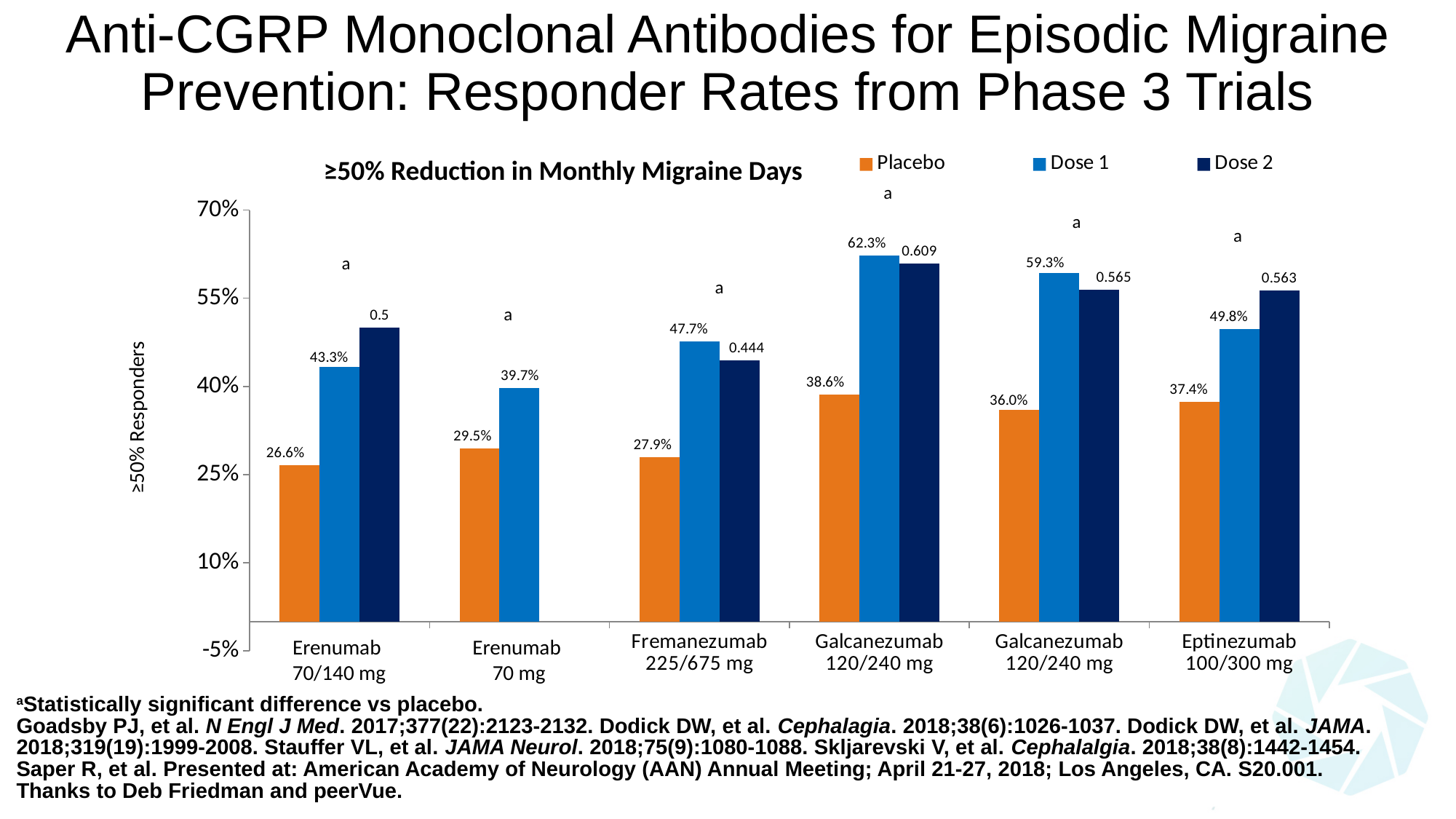
For Erenumab 70 mg, how many percentage points higher is the Dose 1 rate than the Placebo rate? 10.2 percentage points Which group has no Dose 2 bar? Erenumab 70 mg How many drug/dose groups are shown along the x axis? 6 How many series does the legend list? 3 What is the title of the chart? ≥50% Reduction in Monthly Migraine Days Which has the larger Dose 1 responder rate: Fremanezumab 225/675 mg or Eptinezumab 100/300 mg? Eptinezumab 100/300 mg Which group has the lowest Placebo responder rate? Erenumab 70/140 mg What is the Dose 1 responder rate for Fremanezumab 225/675 mg? 47.7% What value is labelled on the Dose 2 bar for Eptinezumab 100/300 mg? 0.563 What is the Placebo responder rate for Erenumab 70/140 mg? 26.6% What kind of chart is shown on the slide? Bar chart What is the highest Dose 1 value shown on the chart? 62.3%